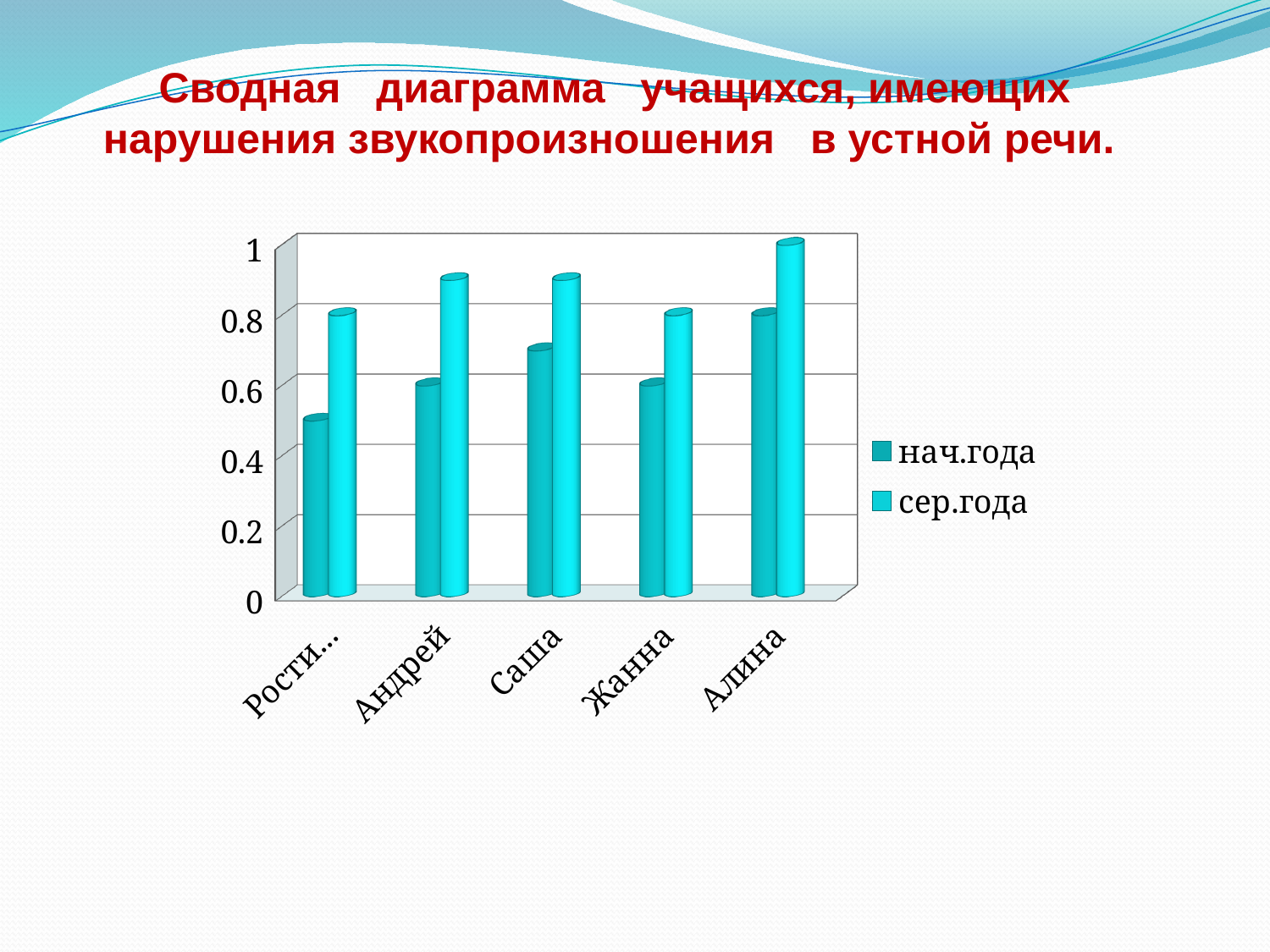
What is the сер.года value for Алина? 1 What kind of chart is shown on the slide? bar chart What is the нач.года value for Алина? 0.8 Which is larger: the сер.года value for Алина or the сер.года value for Жанна? Алина Which is larger: the нач.года value for Саша or the нач.года value for Андрей? Саша Which student has the highest сер.года value? Алина Is the сер.года value for Андрей greater or less than 0.8? greater Is the нач.года value for Саша greater or less than 0.6? greater What are the two series named in the legend? нач.года and сер.года Which student has the highest нач.года value? Алина How many series does the legend list? 2 How many students (categories) are shown on the x axis? 5